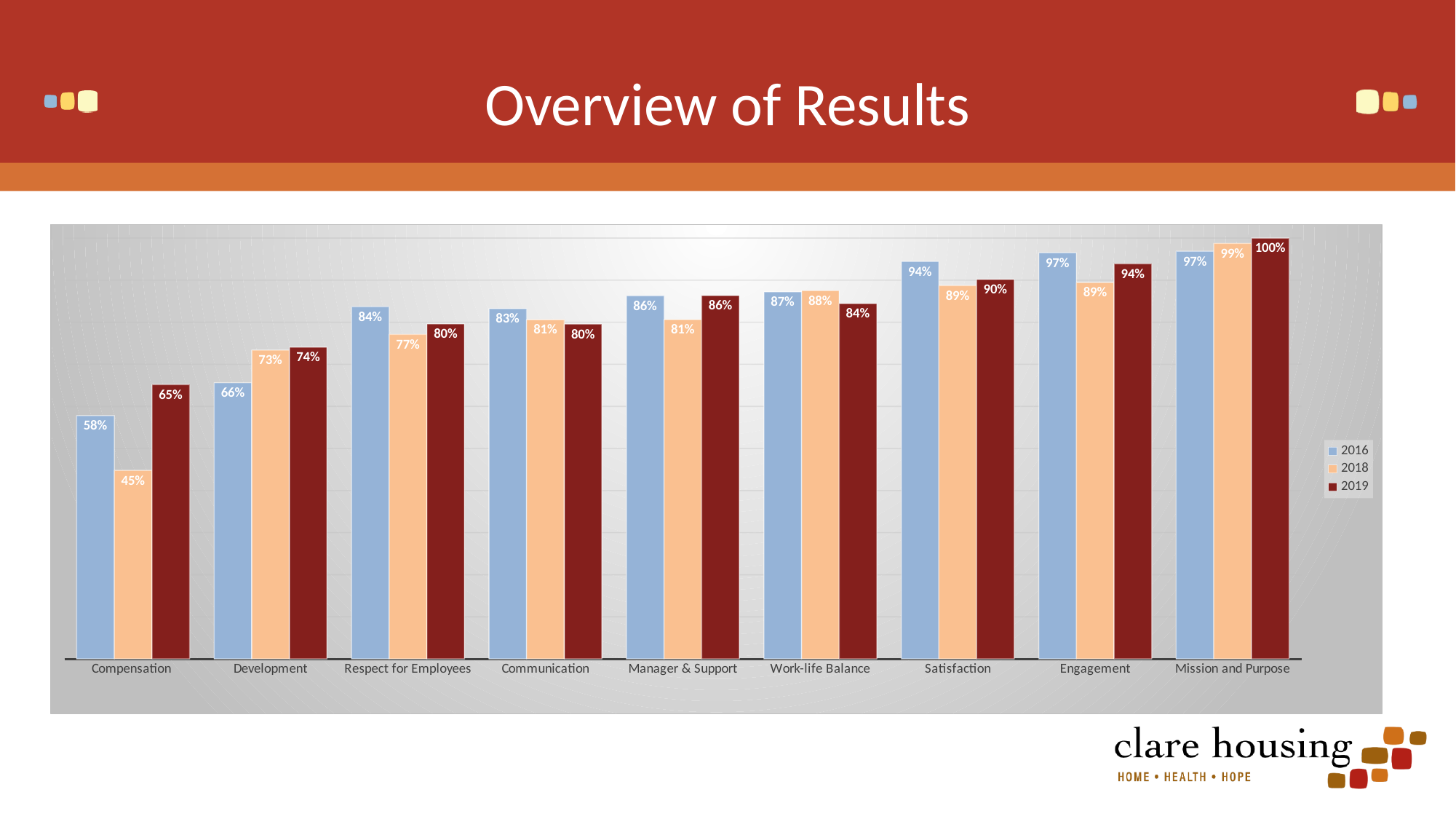
What kind of chart is shown on the slide? Bar chart Do the 2019 values generally rise or fall from Compensation to Mission and Purpose along the x axis? Rise What is the 2016 value for Work-life Balance? 87% Which is larger for Satisfaction: the 2016 value or the 2019 value? 2016 How many categories are shown on the x axis? 9 What is the difference between the 2019 and 2018 values for Compensation? 20% Which category has the lowest 2018 value? Compensation Which category has the highest 2019 value? Mission and Purpose How many series does the legend list? 3 What is the 2019 value for Compensation? 65% Which years are listed in the legend? 2016, 2018, 2019 What is the 2018 value for Development? 73%